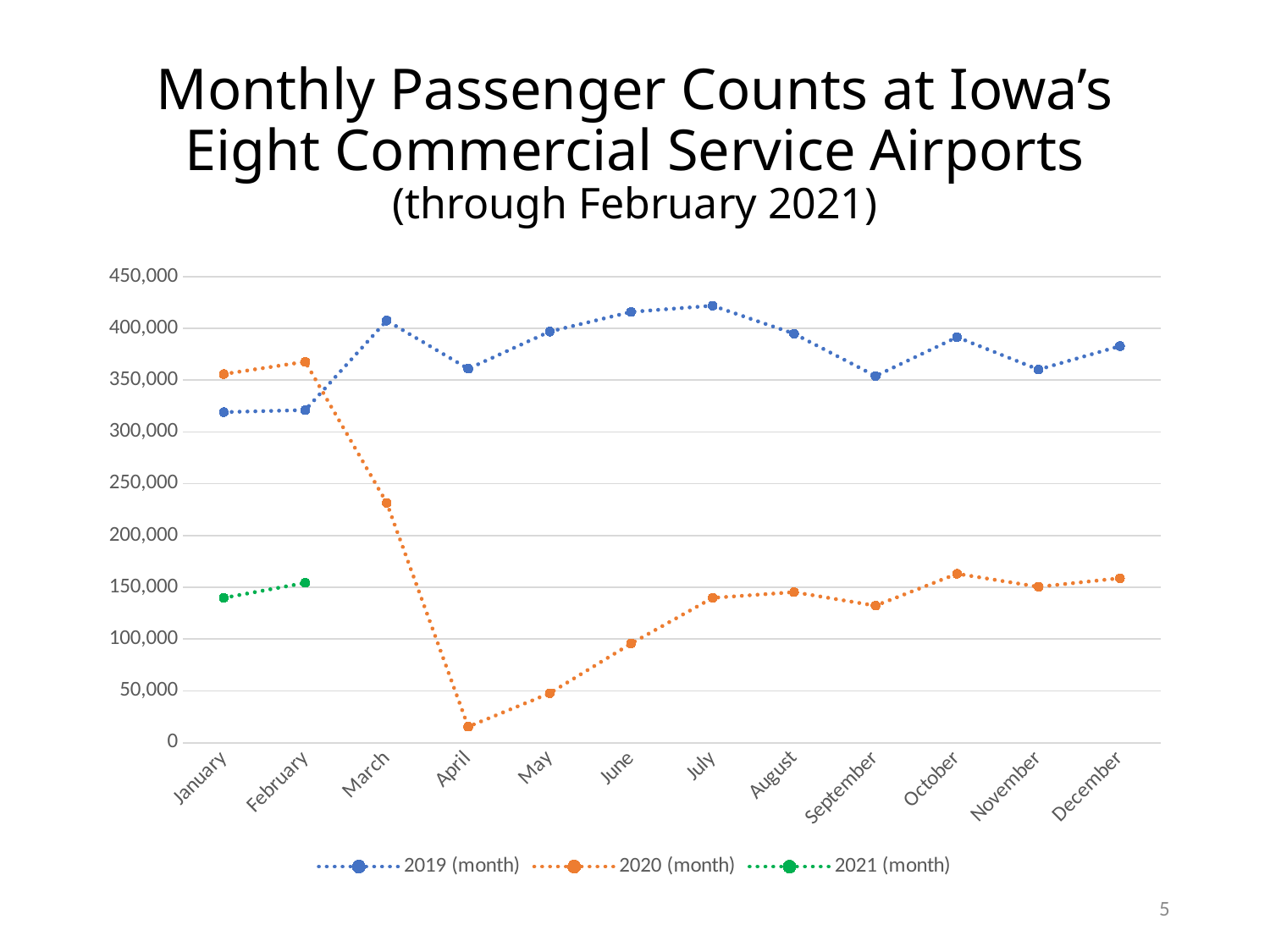
Is the 2020 (month) value for March greater or less than 250,000? less In which month is the 2020 (month) value highest? February Is the 2020 (month) value for April greater or less than 50,000? less Is the 2021 (month) value for February greater or less than 100,000? greater How many series does the legend list? 3 Does the 2020 (month) series rise or fall from February to April? Fall Which is larger in January: the 2019 (month) value or the 2020 (month) value? 2020 (month) In which month is the 2020 (month) value lowest? April How many months are shown along the x axis? 12 Which is larger in March: the 2019 (month) value or the 2020 (month) value? 2019 (month) What kind of chart is shown on the slide? Line chart